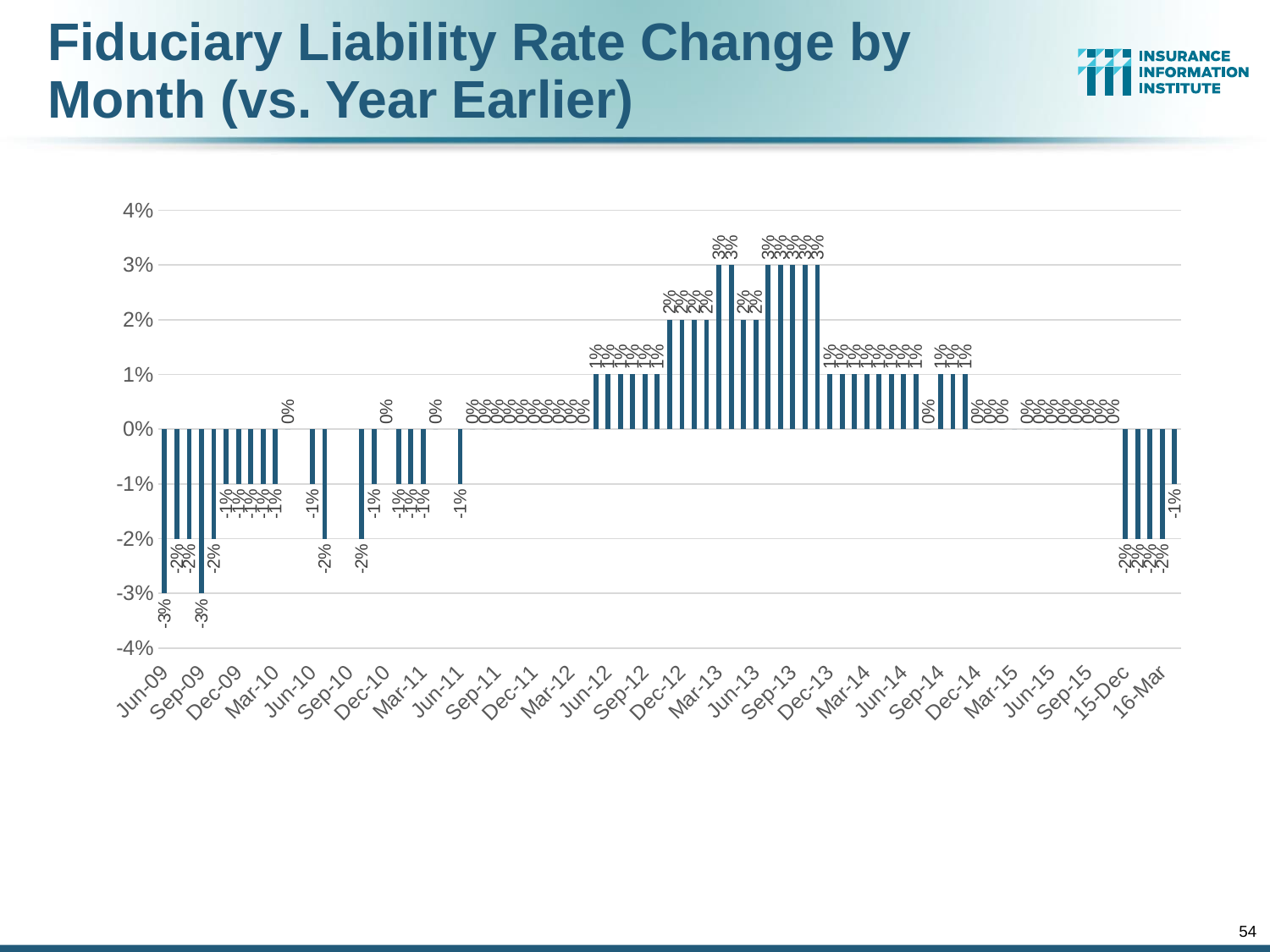
What is the rate change shown for Sep-12? 1% What is the title of the chart? Fiduciary Liability Rate Change by Month (vs. Year Earlier) What kind of chart is shown on the slide? Bar chart What is the highest rate change value shown on the chart? 3% What is the rate change shown for Dec-11? 0% Which has the larger rate change, Jun-09 or 16-Mar? 16-Mar What is the lowest rate change value shown on the chart? -3% Is the value for Sep-13 greater or less than 2%? greater Between Jun-12 and Sep-13, do the rate changes generally rise or fall? Rise What is the rate change shown for Jun-09? -3%